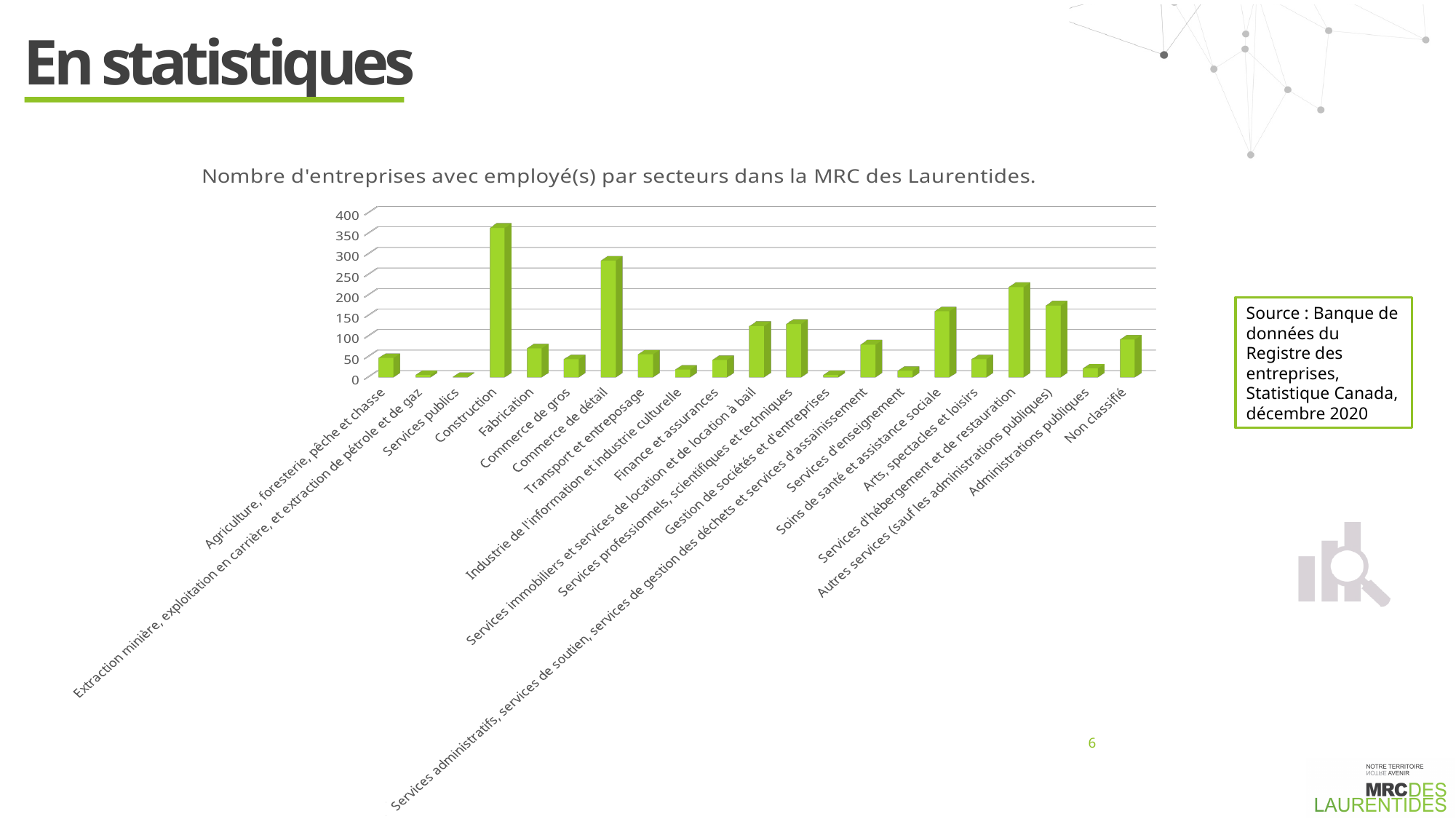
Is the value for Construction greater or less than 300? greater Which sector has the highest number of businesses? Construction Which is larger, the value for Construction or the value for Commerce de détail? Construction Is the value for Services d'hébergement et de restauration greater or less than 200? greater What is the title of the chart? Nombre d'entreprises avec employé(s) par secteurs dans la MRC des Laurentides. How many sectors (categories) are plotted on the x axis? 21 Is the value for Soins de santé et assistance sociale greater or less than 100? greater According to the text box on the slide, what is the source of the chart data? Banque de données du Registre des entreprises, Statistique Canada, décembre 2020 What kind of chart is shown on the slide? bar chart Which is larger, the value for Services d'hébergement et de restauration or the value for Autres services (sauf les administrations publiques)? Services d'hébergement et de restauration